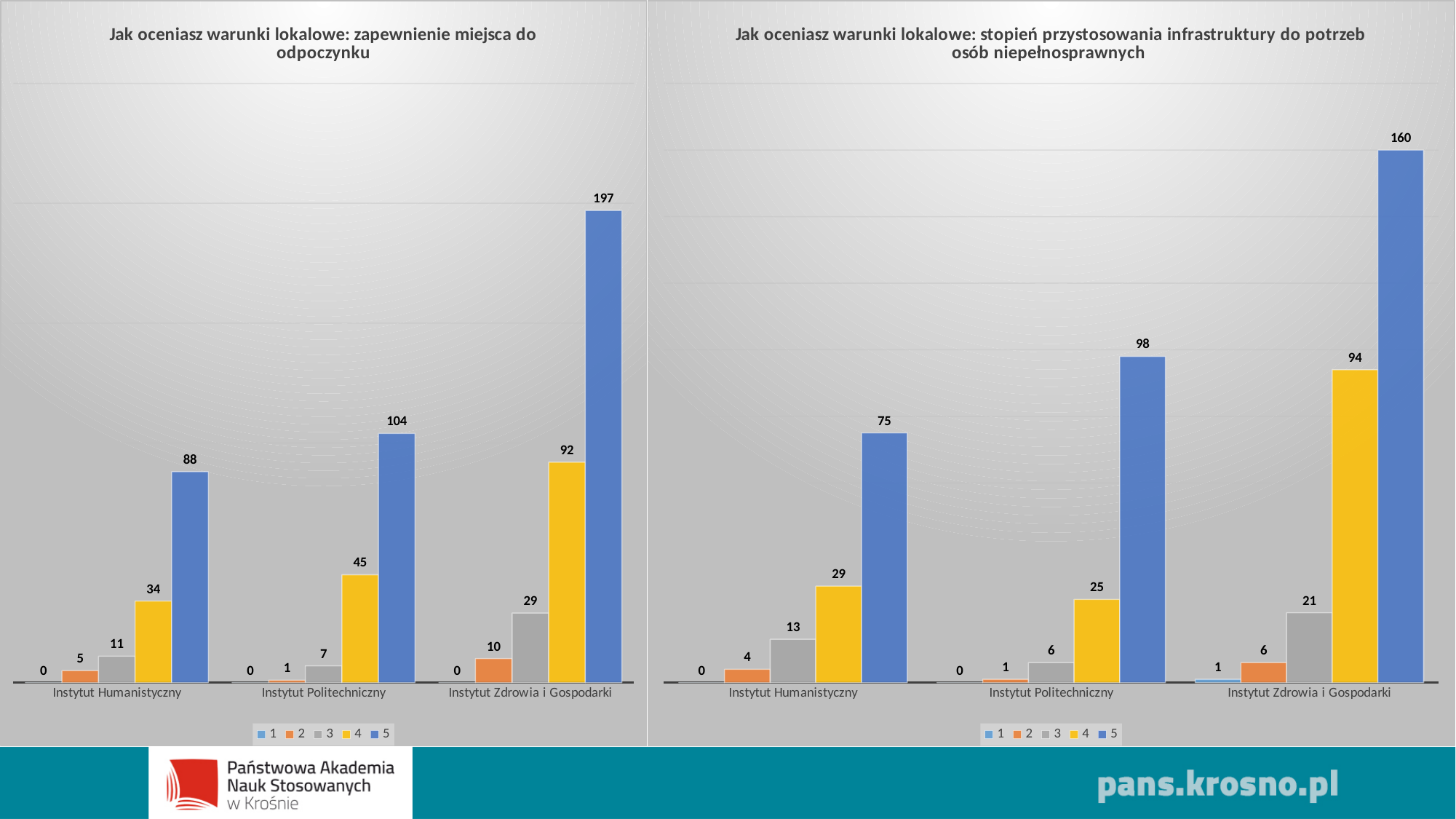
In the left chart (zapewnienie miejsca do odpoczynku), what is the value of series 5 for Instytut Zdrowia i Gospodarki? 197 How many institutes are shown on the x axis of the left chart (zapewnienie miejsca do odpoczynku)? 3 In the right chart (stopień przystosowania infrastruktury), what is the value of series 5 for Instytut Humanistyczny? 75 In the right chart (stopień przystosowania infrastruktury), which institute has the lowest value for series 4? Instytut Politechniczny How many series does the legend of the right chart (stopień przystosowania infrastruktury) list? 5 What type of chart is the left chart (zapewnienie miejsca do odpoczynku)? Bar chart In the left chart (zapewnienie miejsca do odpoczynku), which institute has the highest value for series 5? Instytut Zdrowia i Gospodarki In the left chart (zapewnienie miejsca do odpoczynku), what is the difference between series 5 for Instytut Politechniczny and series 5 for Instytut Humanistyczny? 16 In the left chart (zapewnienie miejsca do odpoczynku), what is the value of series 4 for Instytut Politechniczny? 45 In the right chart (stopień przystosowania infrastruktury), which is larger: series 3 for Instytut Humanistyczny or series 3 for Instytut Politechniczny? Instytut Humanistyczny In the right chart (stopień przystosowania infrastruktury), what is the difference between series 5 and series 4 for Instytut Zdrowia i Gospodarki? 66 In the right chart (stopień przystosowania infrastruktury), what is the value of series 3 for Instytut Zdrowia i Gospodarki? 21